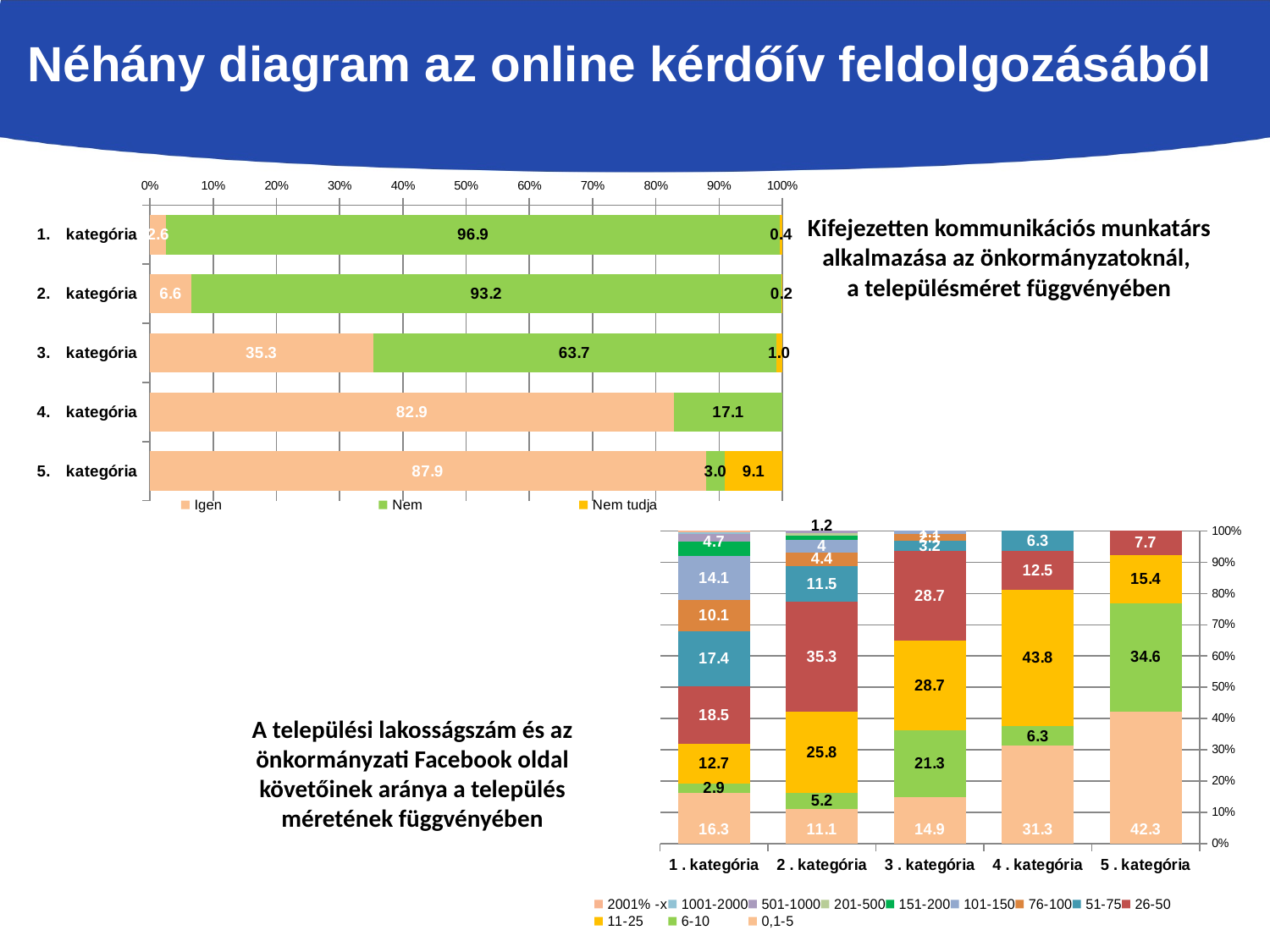
In the bottom-right chart, what is the value of the 11-25 series for 4 . kategória? 43.8 In the top-left chart, what is the value of the Igen series for 4. kategória? 82.9 In the top-left chart, what is the difference between the Igen values for 4. kategória and 3. kategória? 47.6 In the bottom-right chart, how many categories are shown on the x axis? 5 In the bottom-right chart, which category has the highest 0,1-5 value? 5 . kategória In the top-left chart, which category has the highest Igen value? 5. kategória In the bottom-right chart, what is the value of the 0,1-5 series for 5 . kategória? 42.3 In the top-left chart, what is the value of the Nem series for 1. kategória? 96.9 In the top-left chart, what is the value of the Nem tudja series for 5. kategória? 9.1 What type of chart is the top-left chart? Stacked bar chart In the top-left chart, which category has the lowest Nem value? 5. kategória In the top-left chart, how many series does the legend list? 3